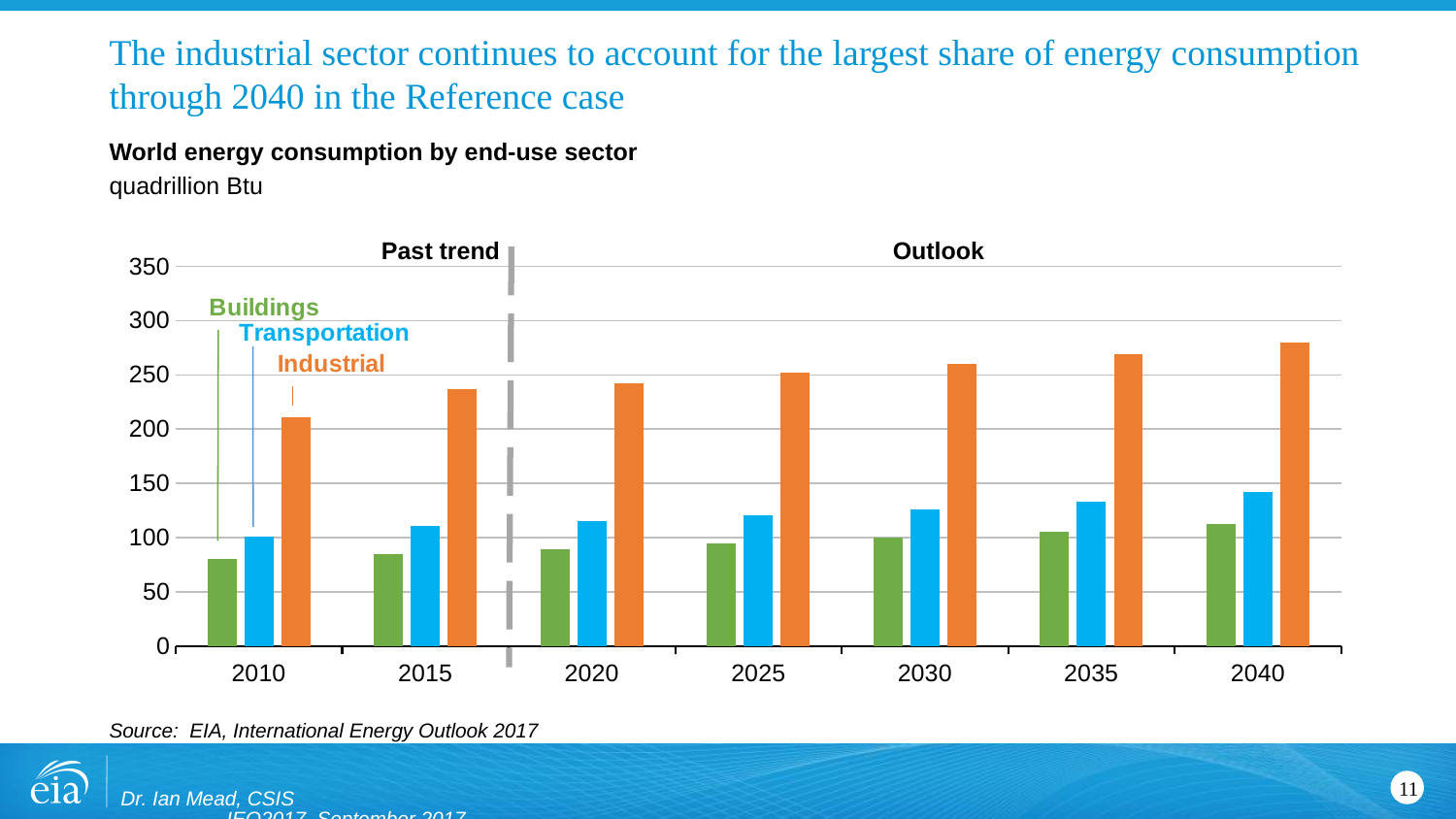
How many sectors (series) are labelled in the chart? 3 Is the Industrial value for 2040 greater or less than 250? greater Which is larger in 2020, the Industrial value or the Transportation value? Industrial What unit is the chart's y axis measured in, according to the subtitle? quadrillion Btu Is the Transportation value for 2040 greater or less than 150? less Which sector has the highest energy consumption in 2040? Industrial How many years are shown on the x axis of the chart? 7 Is the Buildings value for 2010 greater or less than 100? less Does the Industrial sector's energy consumption rise or fall from 2010 to 2040? rise What kind of chart is shown on the slide? bar chart Which sector has the lowest energy consumption in 2010? Buildings